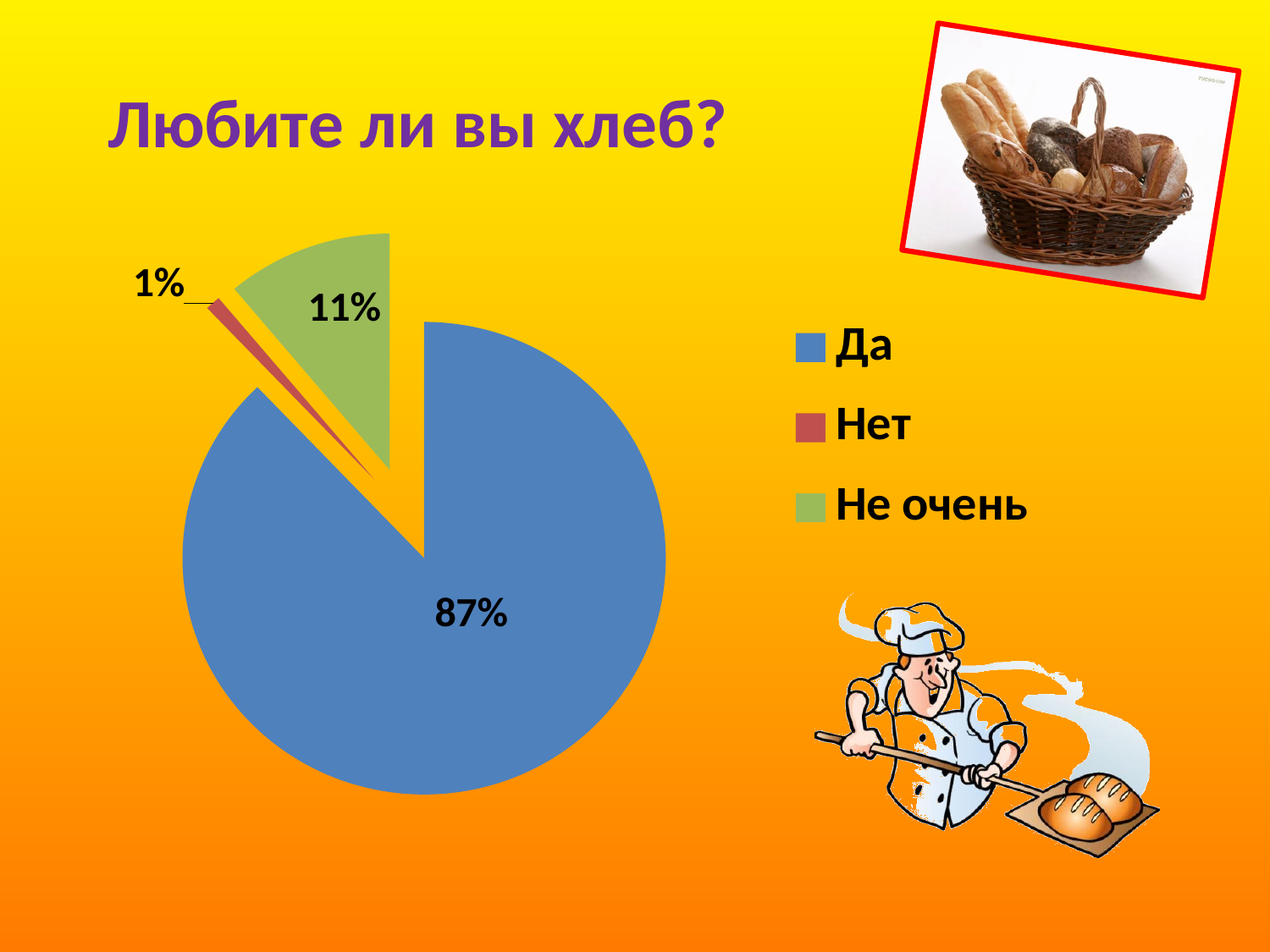
What is the difference in percentage points between "Не очень" and "Нет"? 10% Which category has the smallest slice of the pie? Нет What share of the pie does "Да" take? 87% What is the title of the slide above the chart? Любите ли вы хлеб? Which category has the largest slice of the pie? Да What share of the pie does "Нет" take? 1% What kind of chart is shown on the slide? Pie chart What is the difference in percentage points between "Да" and "Не очень"? 76% How many categories does the pie chart show? 3 What share of the pie does "Не очень" take? 11% What colour is the slice for "Не очень"? Green Which is larger, the slice for "Не очень" or the slice for "Нет"? Не очень